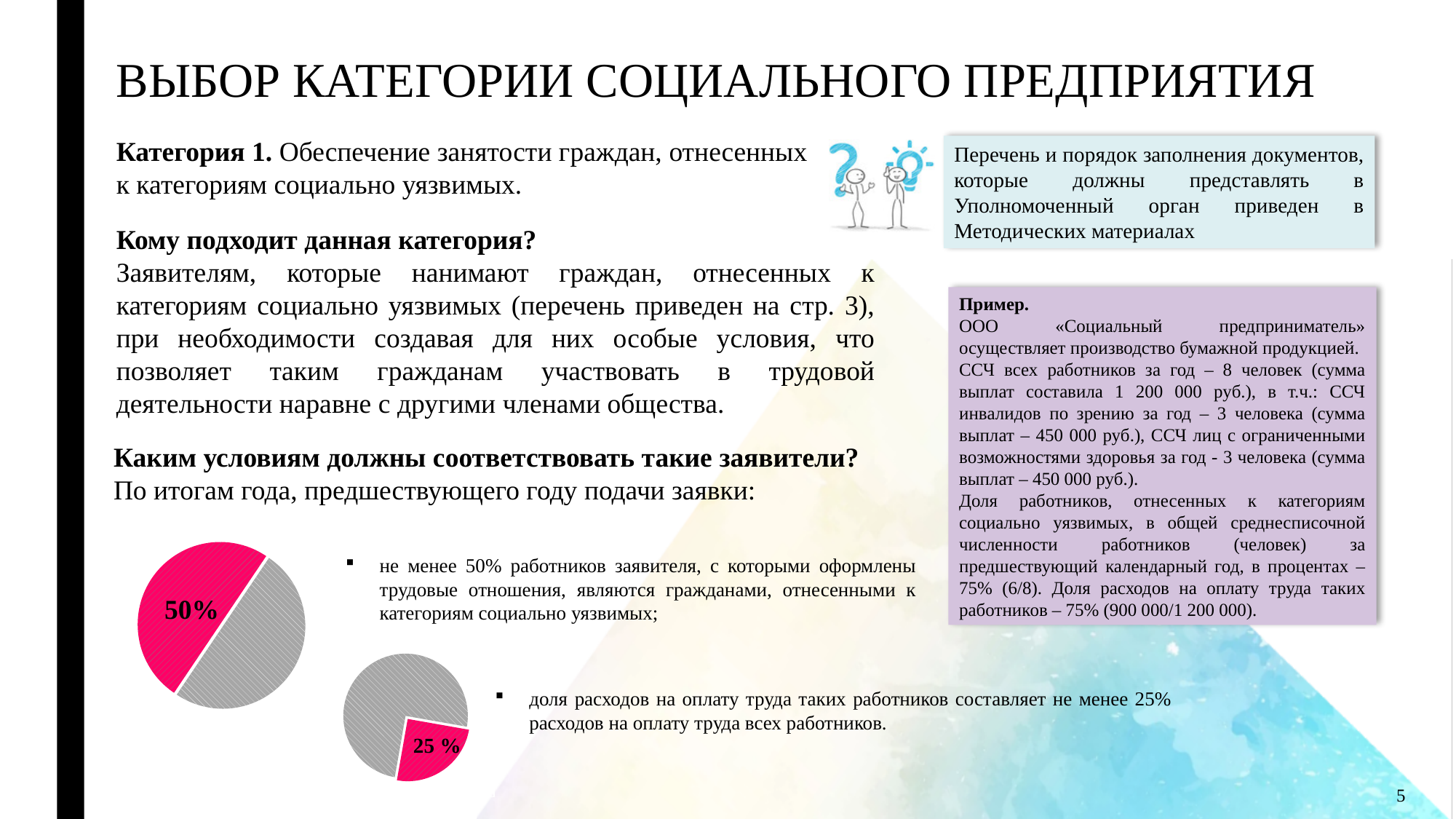
What pattern fills the unlabeled slice in the pie charts? grey hatching How many pie charts are shown on the slide? 2 What kind of chart is the upper-left chart on the slide? pie chart How many slices does the lower pie chart have? 2 Which pie chart has the larger pink slice, the upper-left one or the lower one? the upper-left one What is the difference between the labeled value in the upper-left pie chart and the labeled value in the lower pie chart? 25% In the lower pie chart, is the grey slice greater or less than 50% of the pie? greater In the lower pie chart, what value is printed on the pink slice? 25 % In the upper-left pie chart, what value is printed on the pink slice? 50% In the lower pie chart, what share of the pie does the pink slice represent? 25 % What colour is the labeled slice in each pie chart? pink In the upper-left pie chart, what share of the pie does the pink slice represent? 50%